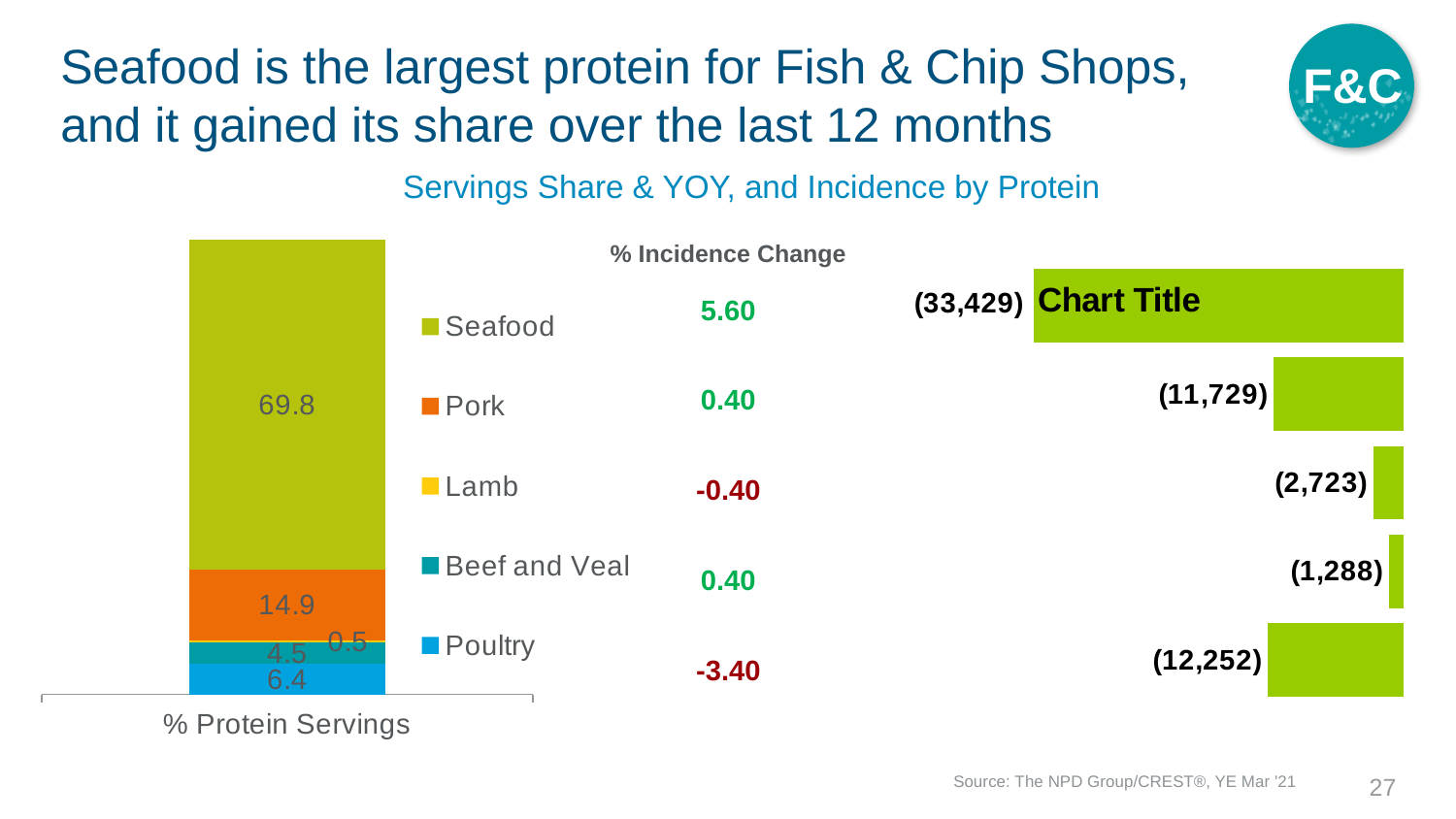
In the stacked bar chart on the left (% Protein Servings), what is the value for Poultry? 6.4 How many series does the legend of the stacked bar chart on the left list? 5 In the stacked bar chart on the left (% Protein Servings), what is the value for Seafood? 69.8 In the stacked bar chart on the left (% Protein Servings), what is the value for Pork? 14.9 In the stacked bar chart on the left (% Protein Servings), which is larger, Beef and Veal or Poultry? Poultry In the stacked bar chart on the left (% Protein Servings), which protein has the smallest share? Lamb In the stacked bar chart on the left (% Protein Servings), what is the difference between the Seafood and Pork values? 54.9 In the % Incidence Change column, what is the value for Seafood? 5.60 What kind of chart is the chart on the left (% Protein Servings)? Stacked bar chart In the % Incidence Change column, what is the value for Poultry? -3.40 In the bar chart on the right (Chart Title), what is the value shown on the top bar, which corresponds to Seafood? (33,429) In the stacked bar chart on the left (% Protein Servings), which protein has the largest share? Seafood